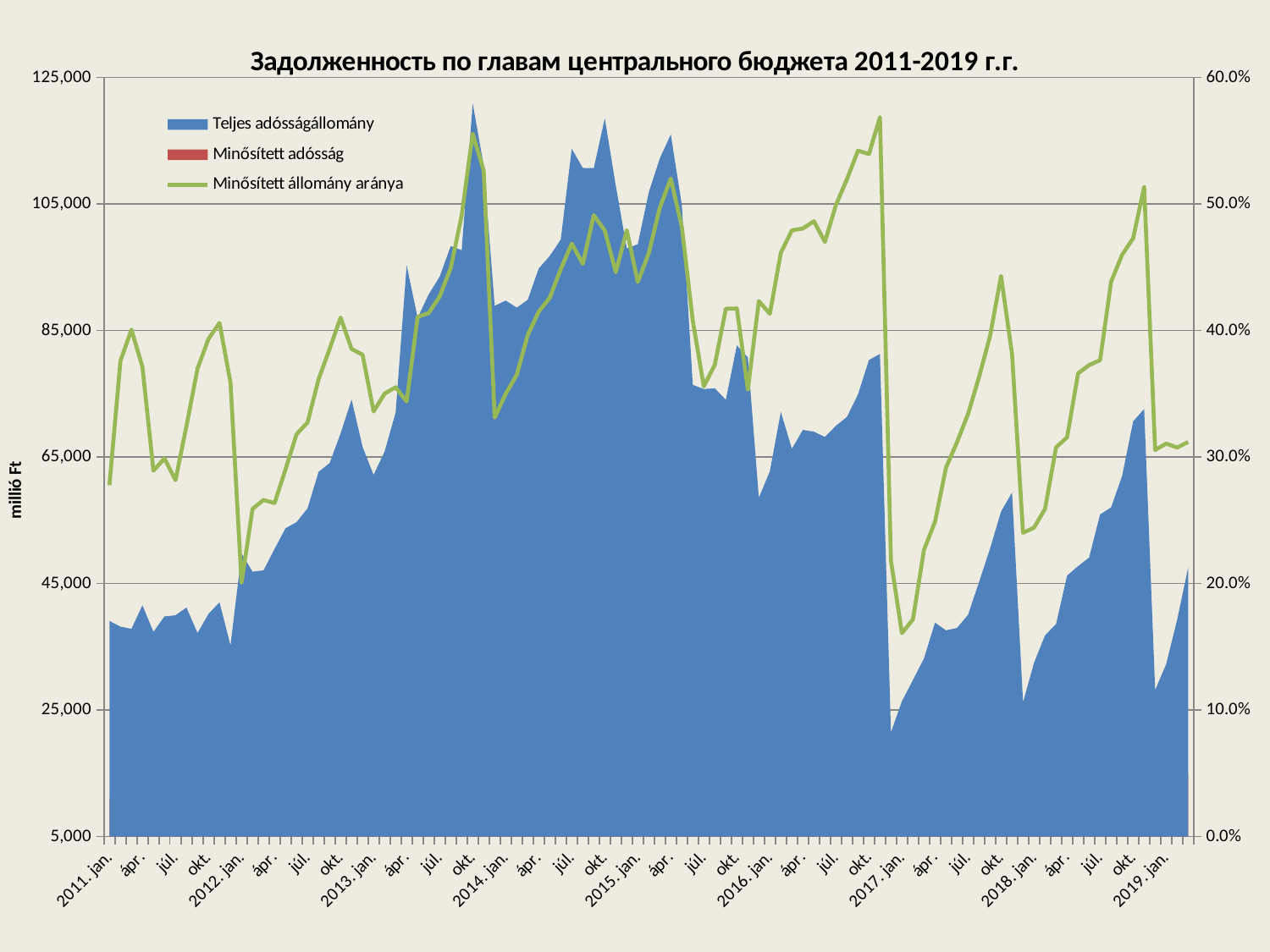
Which series is plotted as a green line? Minősített állomány aránya Is the value of Minősített állomány aránya at 2018. jan. greater or less than 30.0%? less What is the label of the left vertical axis? millió Ft Is the value of Minősített állomány aránya at 2016. okt. greater or less than 50.0%? greater Is the value of Teljes adósságállomány at 2011. jan. greater or less than 45,000? less Does Teljes adósságállomány rise or fall between 2017. jan. and 2017. okt.? rise Does Teljes adósságállomány rise or fall overall between 2014. ápr. and 2016. jan.? fall What kind of chart is shown on the slide? An area chart combined with a line chart How many series does the legend list? 3 What is the title of the chart? Задолженность по главам центрального бюджета 2011-2019 г.г.